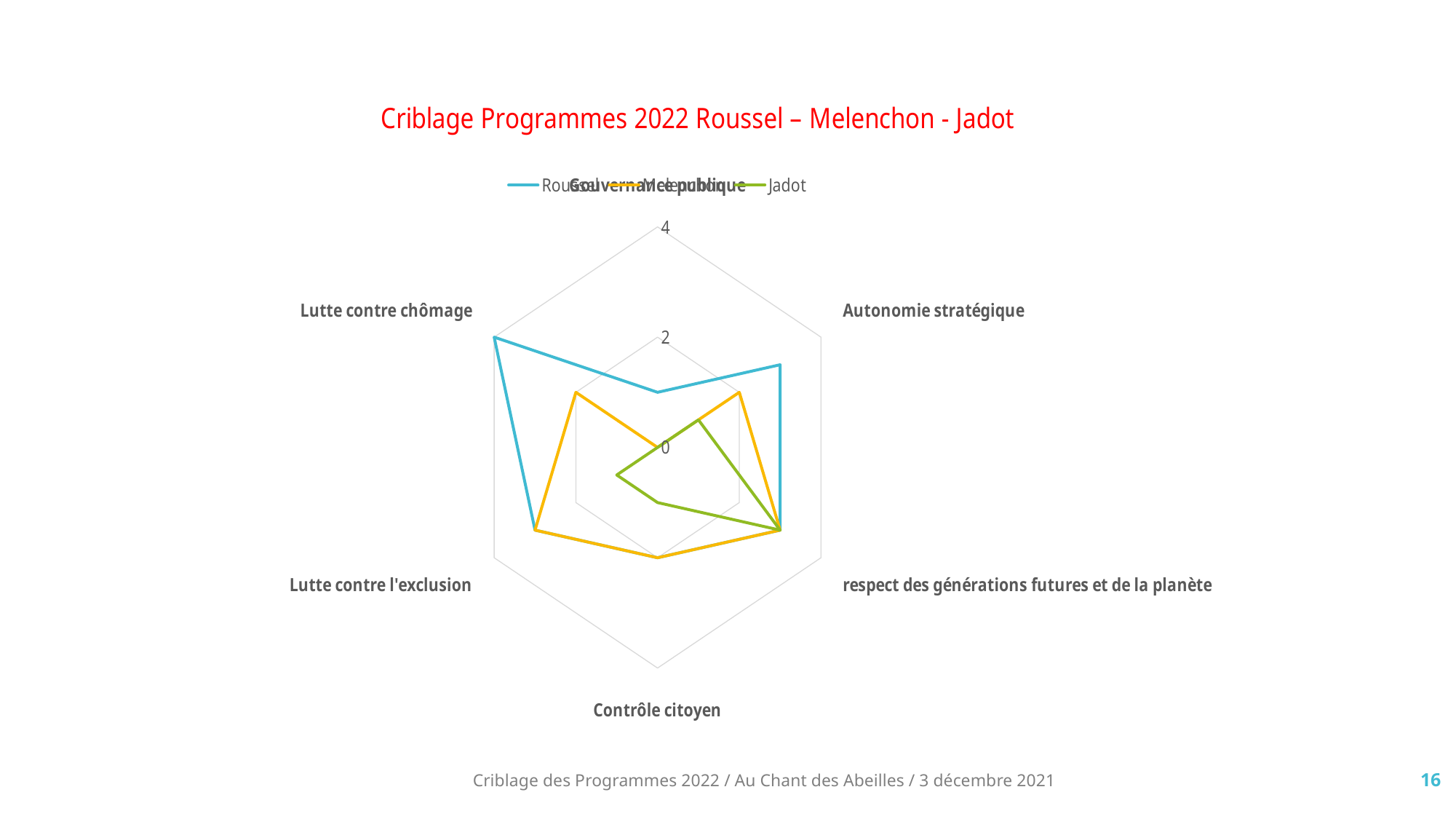
On which category does Jadot have its highest value? respect des générations futures et de la planète What is the value for Melenchon on Gouvernance publique? 0 Is the value for Roussel on Autonomie stratégique greater or less than 2? greater What is the value for Roussel on Lutte contre chômage? 4 What is the title of the chart? Criblage Programmes 2022 Roussel – Melenchon - Jadot On which category does Roussel have its highest value? Lutte contre chômage Is the value for Jadot on Autonomie stratégique greater or less than 2? less How many categories (axes) does the radar chart have? 6 On Lutte contre chômage, which series has the larger value, Roussel or Jadot? Roussel What is the value for Melenchon on Contrôle citoyen? 2 How many series does the legend list? 3 What kind of chart is shown on the slide? Radar chart